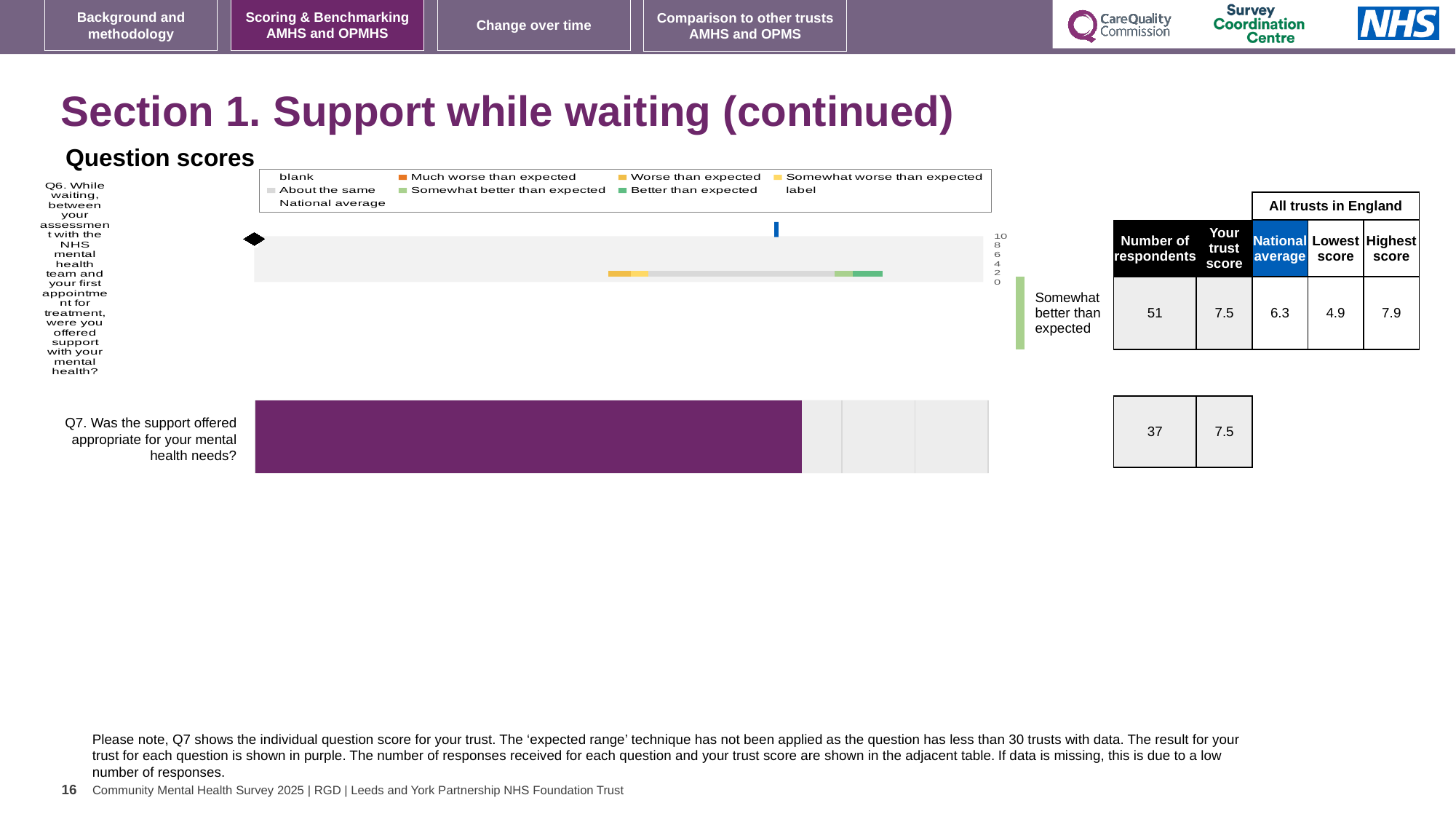
What is the national average score for Q6? 6.3 Which is larger for Q6: the trust score or the national average? the trust score What is the lowest score among all trusts in England for Q6? 4.9 What is the difference between the trust score and the national average for Q6? 1.2 How many respondents answered Q7 (was the support offered appropriate for your mental health needs)? 37 What is the trust score for Q6 (support offered with your mental health while waiting)? 7.5 How many respondents answered Q6? 51 What kind of chart is used to show the question scores? bar chart What is the trust score for Q7? 7.5 Is the value of the Q7 bar greater or less than 6? greater What is the highest score among all trusts in England for Q6? 7.9 Which expected-range category is the Q6 trust score placed in? Somewhat better than expected